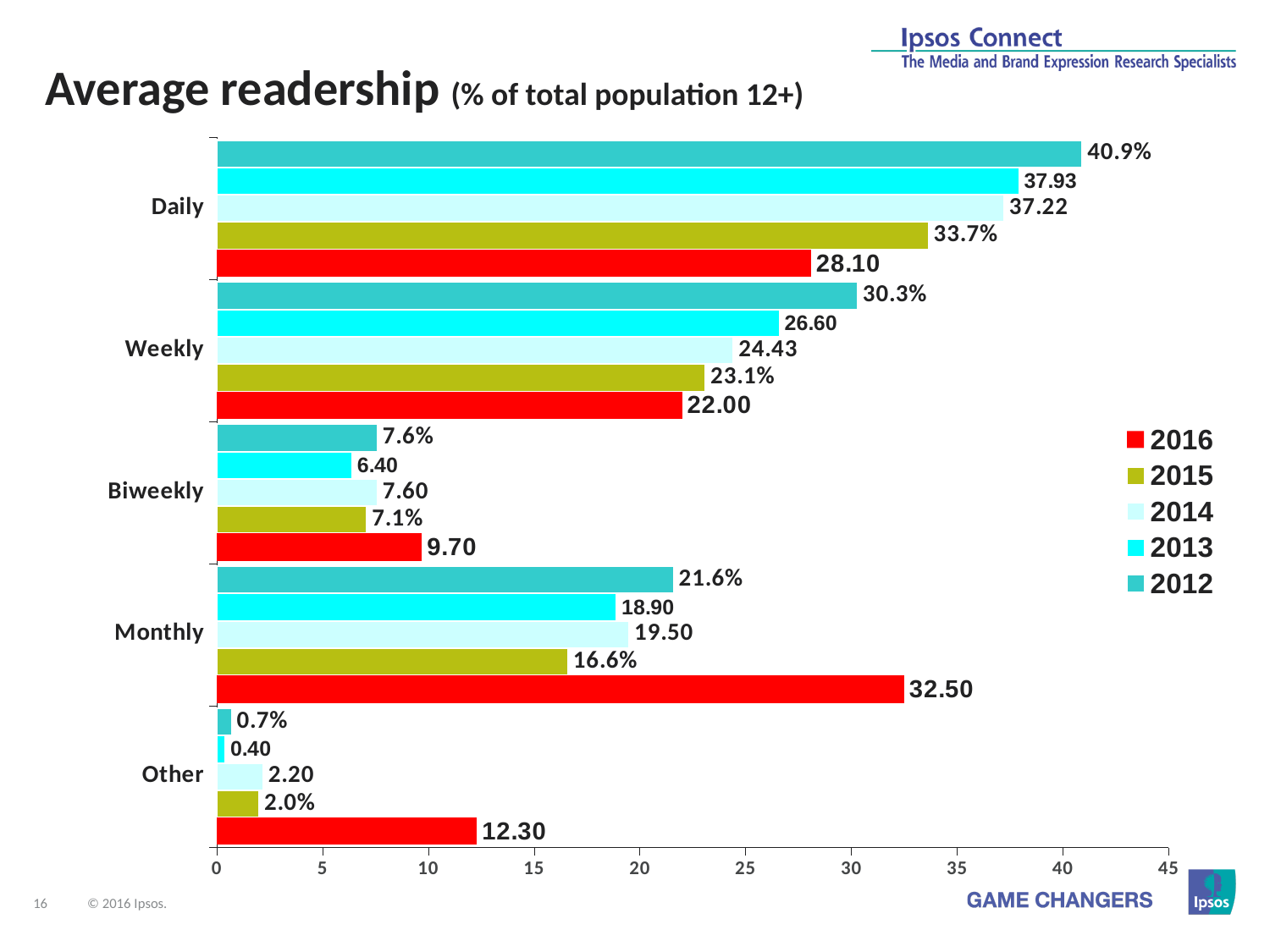
What is the 2014 value for Weekly readership? 24.43 What is the 2012 value for Monthly readership? 21.6% Which colour represents 2016 in the legend? Red How many series does the legend list? 5 What is the difference between the 2016 and 2015 values for Monthly readership? 15.9 How many readership categories are shown on the y axis? 5 What kind of chart is shown on the slide? Bar chart Which year has the lowest Other readership value? 2013 For Biweekly readership, which is larger: the 2016 value or the 2013 value? 2016 What is the 2016 value for Other readership? 12.30 What is the 2016 value for Daily readership? 28.10 Which year has the highest Daily readership value? 2012